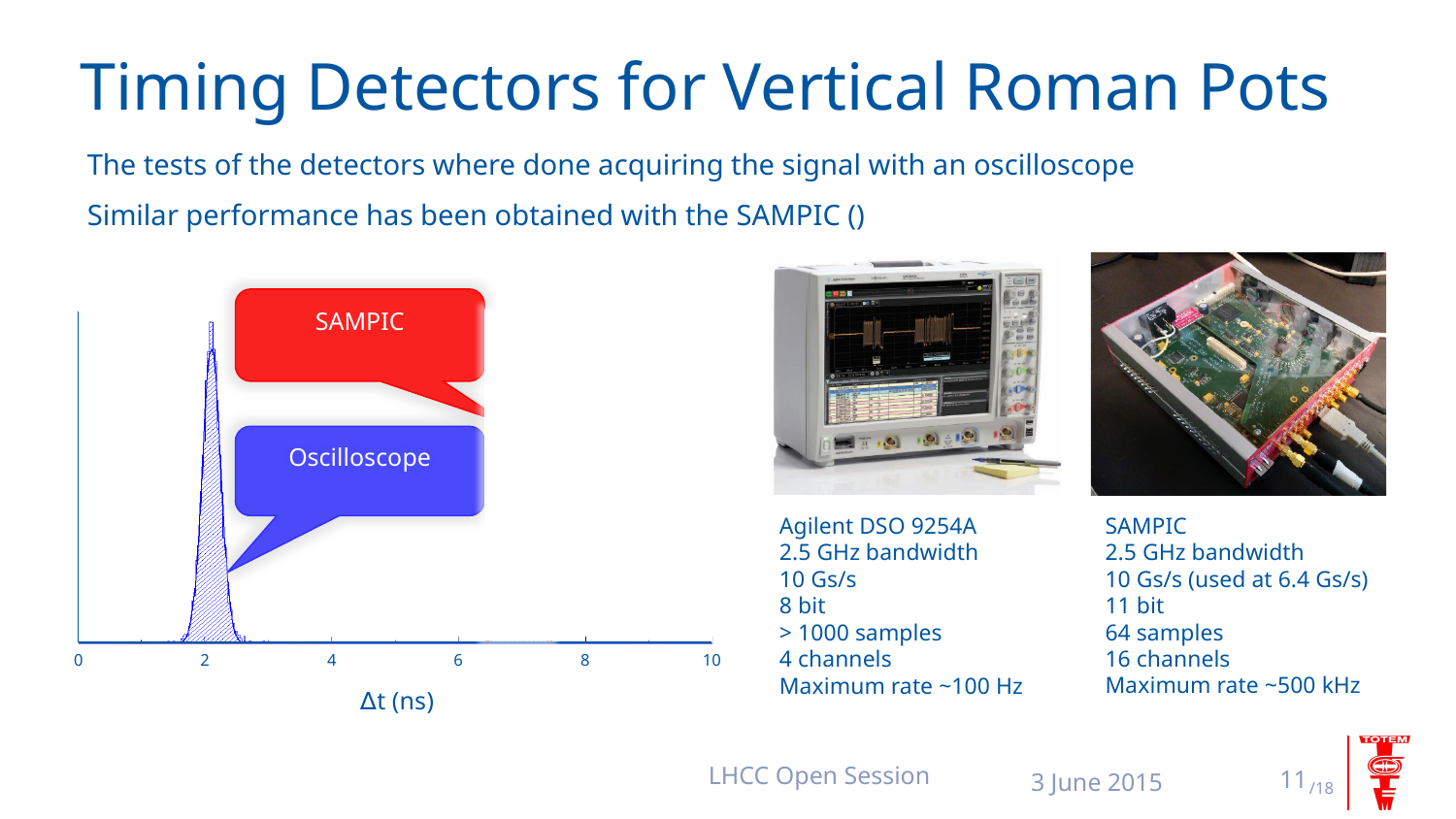
In the chart on the left, is the distribution higher near Δt = 2 ns or near Δt = 8 ns? near Δt = 2 ns What are the two labels shown in the callout boxes over the chart on the left? SAMPIC and Oscilloscope Is the peak of the distribution in the chart on the left located at a Δt greater or less than 4 ns? less Is the peak of the distribution in the chart on the left located at a Δt greater or less than 6 ns? less How many tick labels are shown on the x axis of the chart on the left? 6 In the chart on the left, do the values rise or fall as Δt increases from 2 ns to 4 ns? fall What is the label of the x axis of the chart on the left? Δt (ns) What is the largest value shown on the x axis of the chart on the left? 10